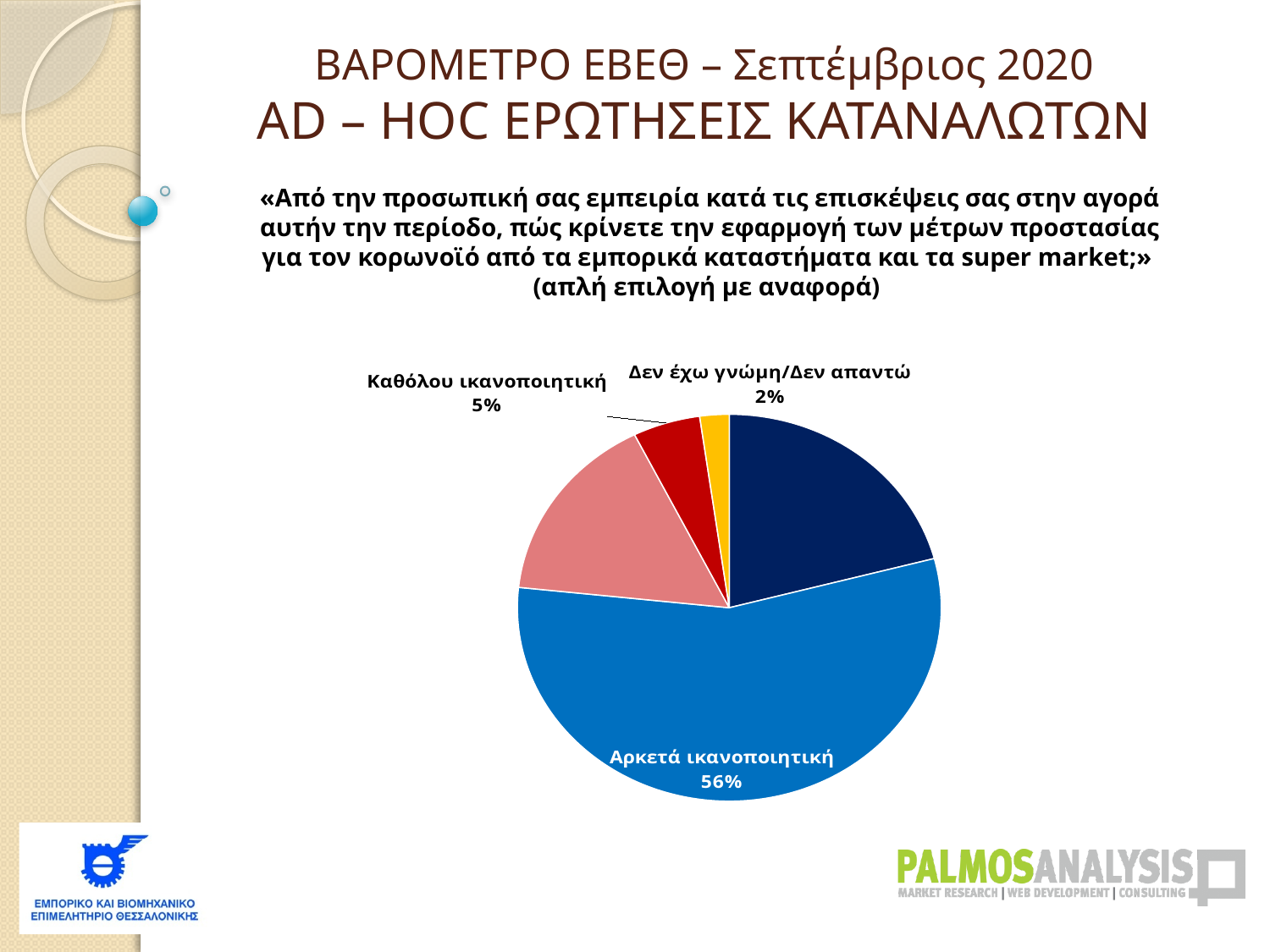
What percentage of respondents answered "Αρκετά ικανοποιητική"? 56% Which labelled category has the largest share of the pie? Αρκετά ικανοποιητική What is the difference in percentage points between "Αρκετά ικανοποιητική" and "Καθόλου ικανοποιητική"? 51 percentage points What kind of chart is shown on the slide? pie chart What share of the pie does the "Αρκετά ικανοποιητική" slice represent? 56% Which category has the smallest slice of the pie? Δεν έχω γνώμη/Δεν απαντώ What percentage of respondents answered "Καθόλου ικανοποιητική"? 5% Is the share for "Αρκετά ικανοποιητική" greater or less than 50%? greater Which is larger: the share for "Καθόλου ικανοποιητική" or for "Δεν έχω γνώμη/Δεν απαντώ"? Καθόλου ικανοποιητική How many slices does the pie chart have? 5 What percentage of respondents answered "Δεν έχω γνώμη/Δεν απαντώ"? 2% What colour is the "Αρκετά ικανοποιητική" slice? blue